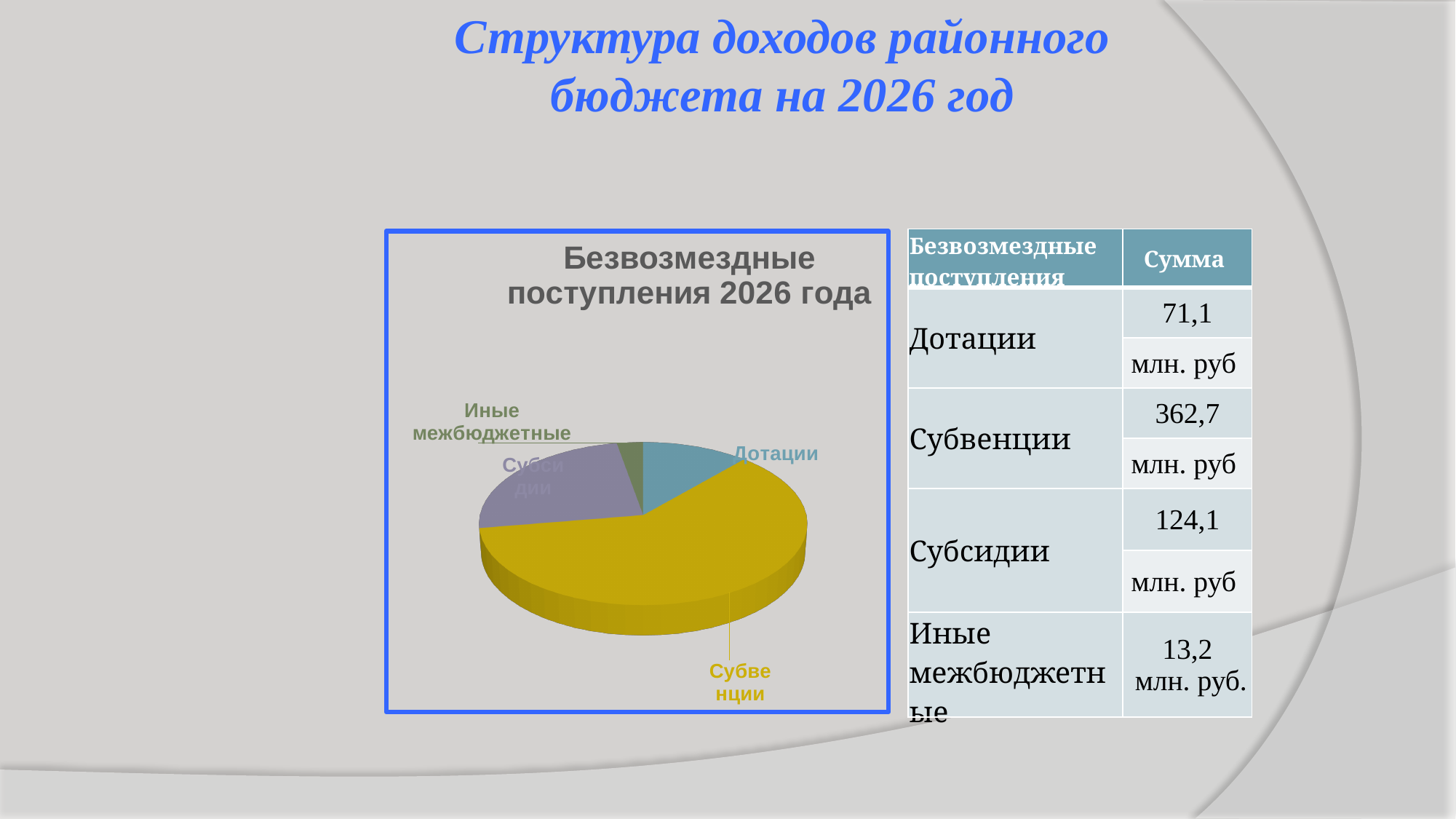
Which category has the largest slice in the pie chart? Субвенции What kind of chart is shown on the slide? Pie chart Which category has the smallest slice in the pie chart? Иные межбюджетные How many slices does the pie chart have? 4 What colour is the Субвенции slice in the pie chart? Yellow What is the difference between the values for Субвенции and Дотации? 291,6 млн. руб What is the title of the pie chart? Безвозмездные поступления 2026 года What is the value for Дотации? 71,1 млн. руб What is the value for Иные межбюджетные? 13,2 млн. руб. What is the value for Субвенции? 362,7 млн. руб What is the value for Субсидии? 124,1 млн. руб Which slice is larger, Субсидии or Дотации? Субсидии